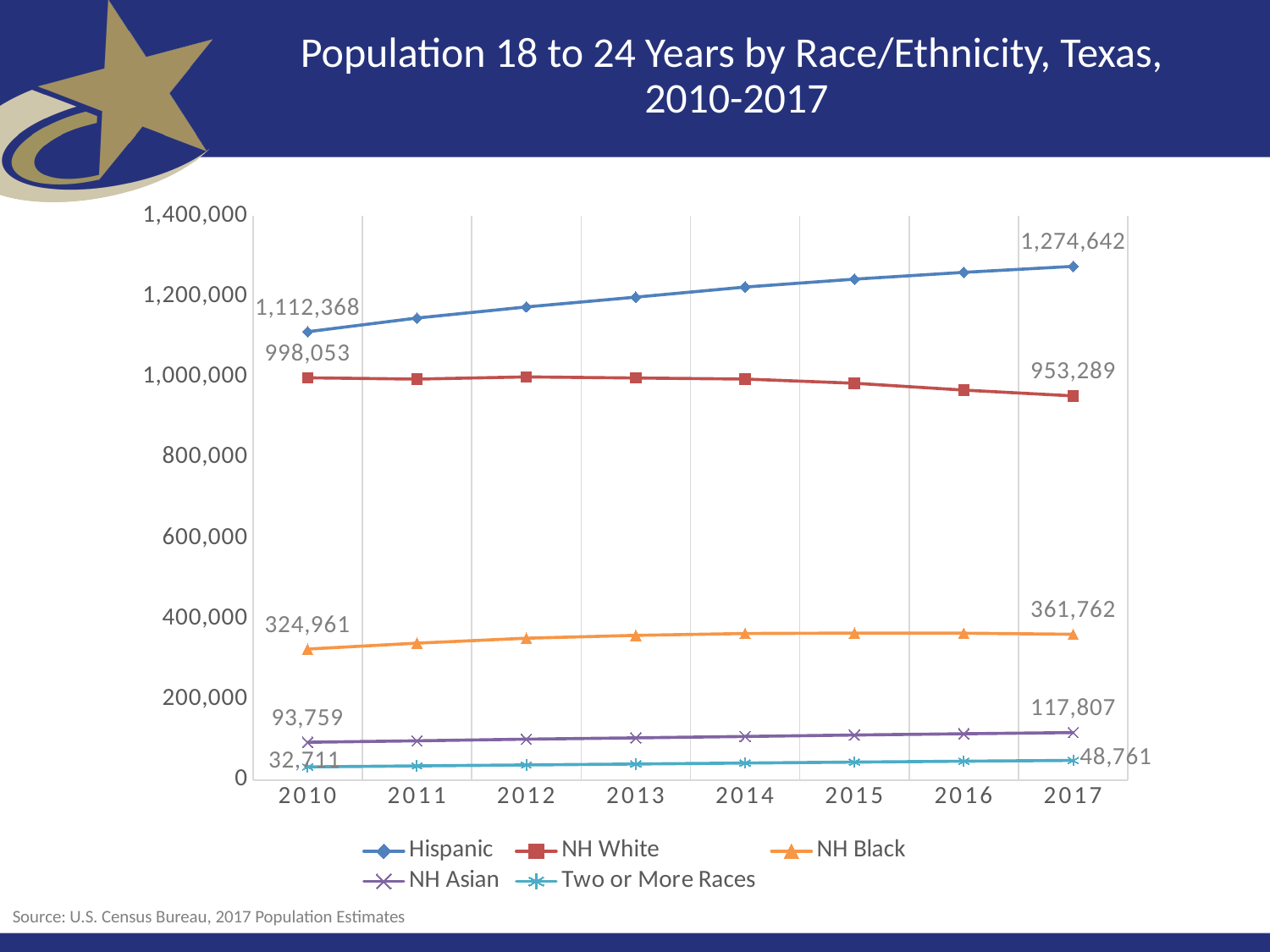
What is the NH Black population value shown for 2017? 361,762 By how much did the NH White population decrease from 2010 to 2017? 44,764 By how much did the Hispanic population increase from 2010 to 2017? 162,274 What is the NH White population value shown for 2010? 998,053 Does the NH White series rise or fall from 2010 to 2017? fall What is the Hispanic population value shown for 2017? 1,274,642 Which series has the highest value in 2017? Hispanic Which series has the lowest value in 2010? Two or More Races Is the NH White value for 2015 greater or less than 800,000? greater Which is larger in 2017: the NH Asian value or the Two or More Races value? NH Asian How many series does the legend list? 5 What is the Two or More Races population value shown for 2010? 32,711